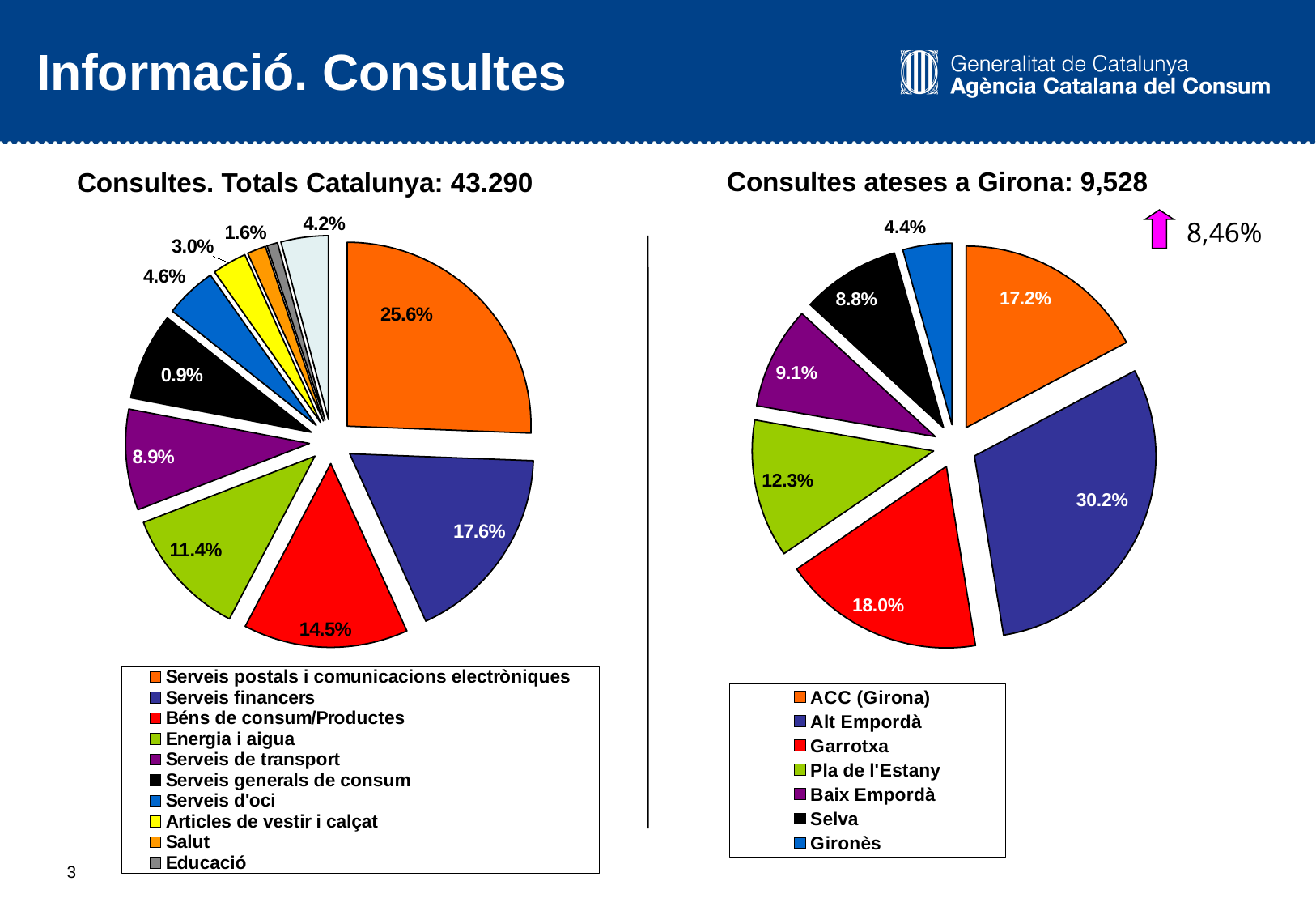
In the chart 'Consultes ateses a Girona: 9,528', which is larger, Pla de l'Estany or Baix Empordà? Pla de l'Estany In the chart 'Consultes ateses a Girona: 9,528', what is the difference in percentage points between Garrotxa and ACC (Girona)? 0.8 percentage points In the chart 'Consultes. Totals Catalunya: 43.290', what percentage is shown for Serveis financers? 17.6% In the chart 'Consultes. Totals Catalunya: 43.290', what is the difference in percentage points between Serveis postals i comunicacions electròniques and Béns de consum/Productes? 11.1 percentage points In the chart 'Consultes ateses a Girona: 9,528', which category has the largest slice? Alt Empordà In the chart 'Consultes ateses a Girona: 9,528', which category has the smallest slice? Gironès What kind of chart is 'Consultes. Totals Catalunya: 43.290'? Pie chart In the chart 'Consultes. Totals Catalunya: 43.290', which is larger, Energia i aigua or Serveis de transport? Energia i aigua In the chart 'Consultes. Totals Catalunya: 43.290', which category has the largest slice? Serveis postals i comunicacions electròniques In the chart 'Consultes ateses a Girona: 9,528', what percentage is shown for Selva? 8.8% In the chart 'Consultes ateses a Girona: 9,528', what percentage is shown for Alt Empordà? 30.2% How many categories does the legend of the chart 'Consultes ateses a Girona: 9,528' list? 7